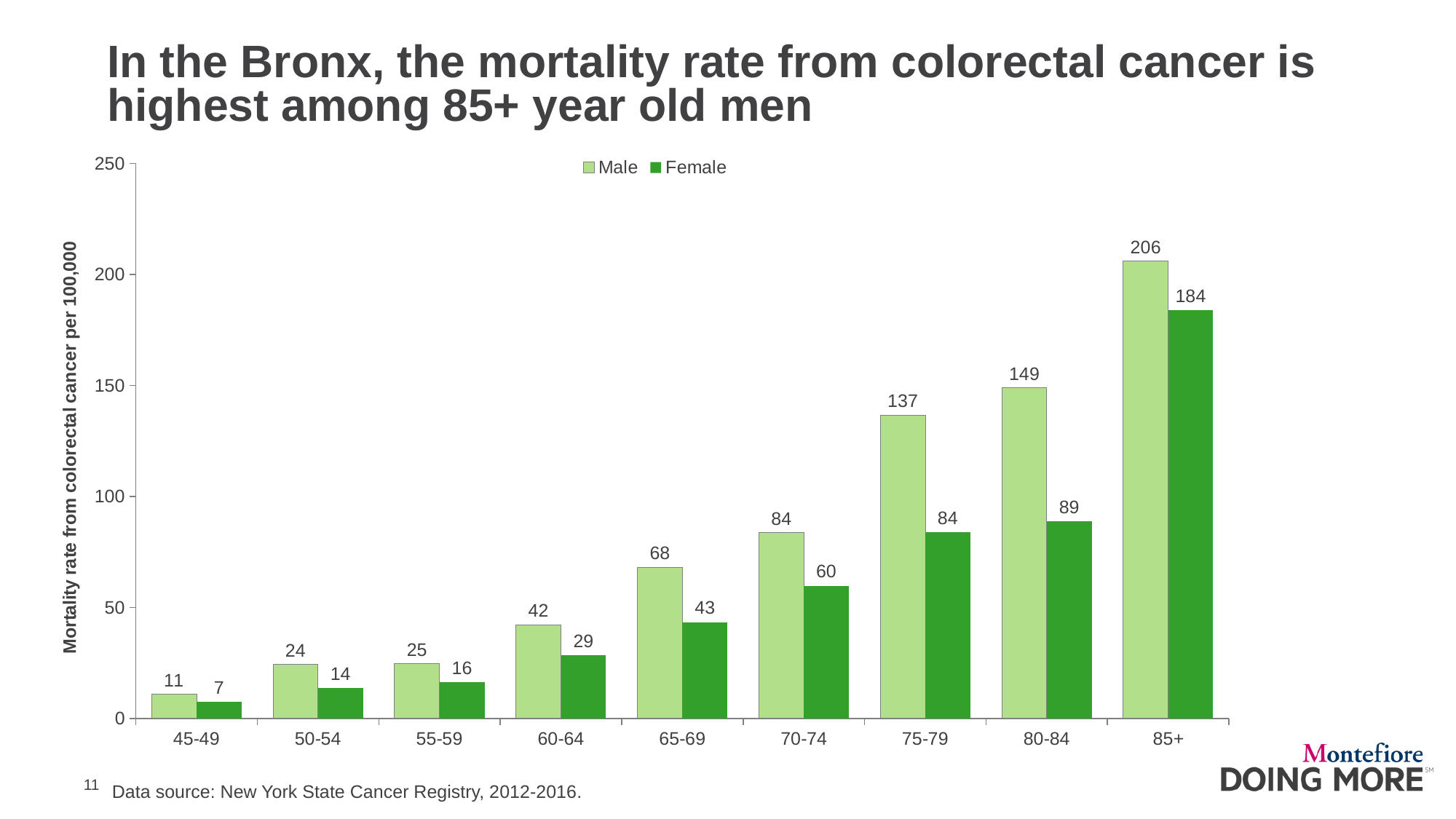
What is the difference between the Male rates for the 80-84 and 75-79 age groups? 12 Which is larger, the Male rate for 65-69 or the Female rate for 70-74? Male rate for 65-69 Do the Male mortality rates rise or fall as age increases along the x axis? Rise What is the difference between the Male and Female mortality rates for the 85+ age group? 22 Which age group has the lowest Male mortality rate? 45-49 How many age groups are shown on the x axis? 9 What is the Female mortality rate for the 60-64 age group? 29 What is the Male mortality rate for the 75-79 age group? 137 How many series does the legend list? 2 Which age group has the highest Female mortality rate? 85+ What is the label of the y axis? Mortality rate from colorectal cancer per 100,000 What kind of chart is shown on the slide? Bar chart